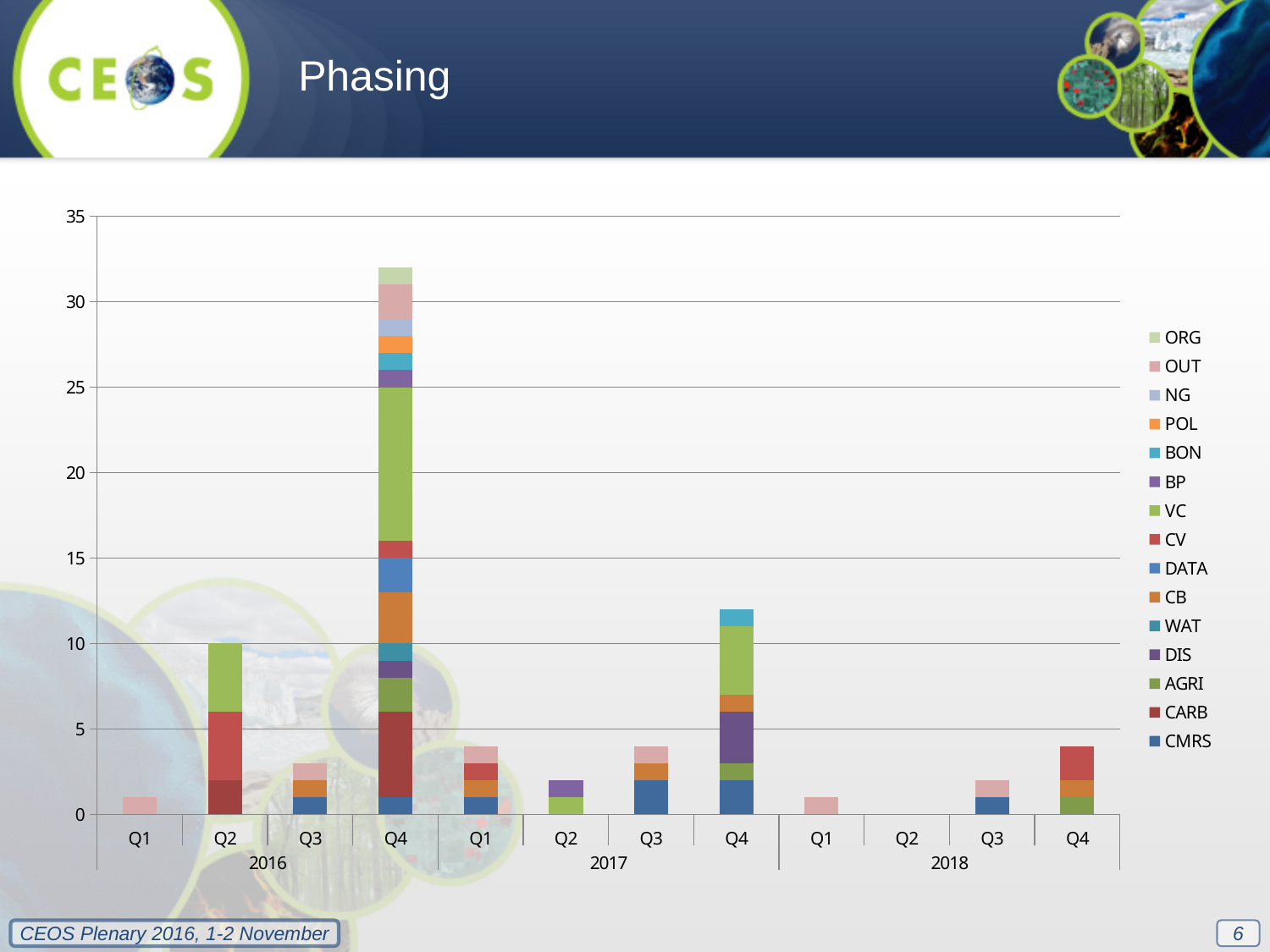
Is the total for Q4 2017 greater or less than 10? greater Which quarter has the tallest stacked bar? Q4 2016 Which is larger, the total for Q4 2017 or the total for Q4 2018? Q4 2017 Is the total for Q1 2017 greater or less than 5? less Which series is listed first (at the top) in the legend? ORG Which is larger, the total for Q2 2016 or the total for Q3 2016? Q2 2016 How many series does the legend list? 15 Is the total for Q3 2016 greater or less than 5? less How many quarterly categories are plotted along the x axis? 12 What is the title of the slide containing the chart? Phasing What kind of chart is shown on the slide? stacked bar chart